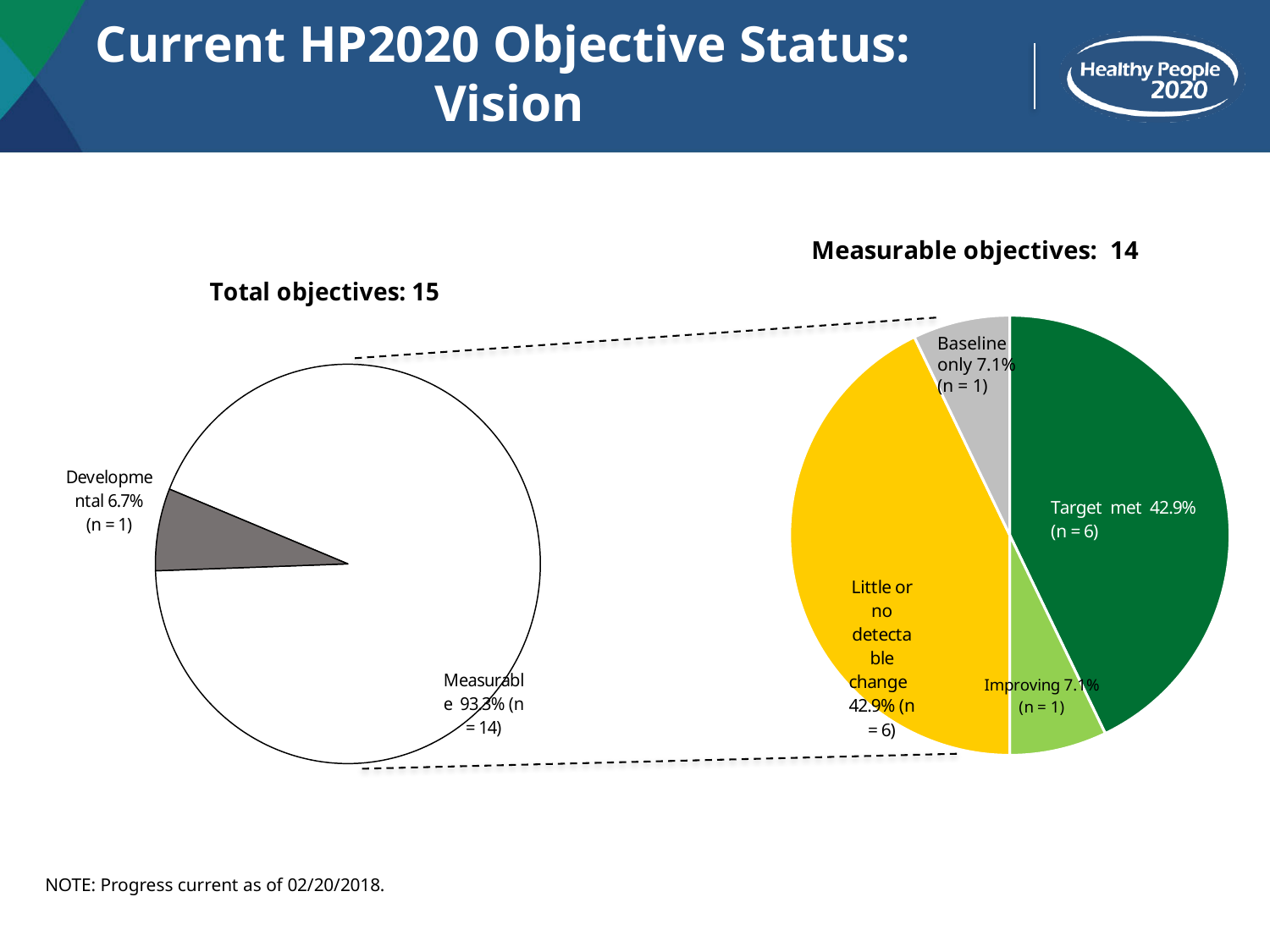
How many slices does the "Total objectives: 15" pie chart have? 2 What kind of chart is used on the left side of the slide under "Total objectives: 15"? Pie chart How many slices does the "Measurable objectives: 14" pie chart have? 4 In the "Measurable objectives: 14" pie chart, what percentage of objectives have Target met? 42.9% In the "Total objectives: 15" pie chart, what share of objectives is Developmental? 6.7% In the "Total objectives: 15" pie chart, which slice is larger, Developmental or Measurable? Measurable In the "Total objectives: 15" pie chart, how many objectives are Measurable? 14 In the "Measurable objectives: 14" pie chart, what is the difference in percentage points between Target met and Improving? 35.8 In the "Measurable objectives: 14" pie chart, how many objectives are Improving? 1 In the "Measurable objectives: 14" pie chart, how many objectives show Little or no detectable change? 6 In the "Measurable objectives: 14" pie chart, what percentage of objectives are Baseline only? 7.1% In the "Measurable objectives: 14" pie chart, what colour is the Target met slice? Dark green